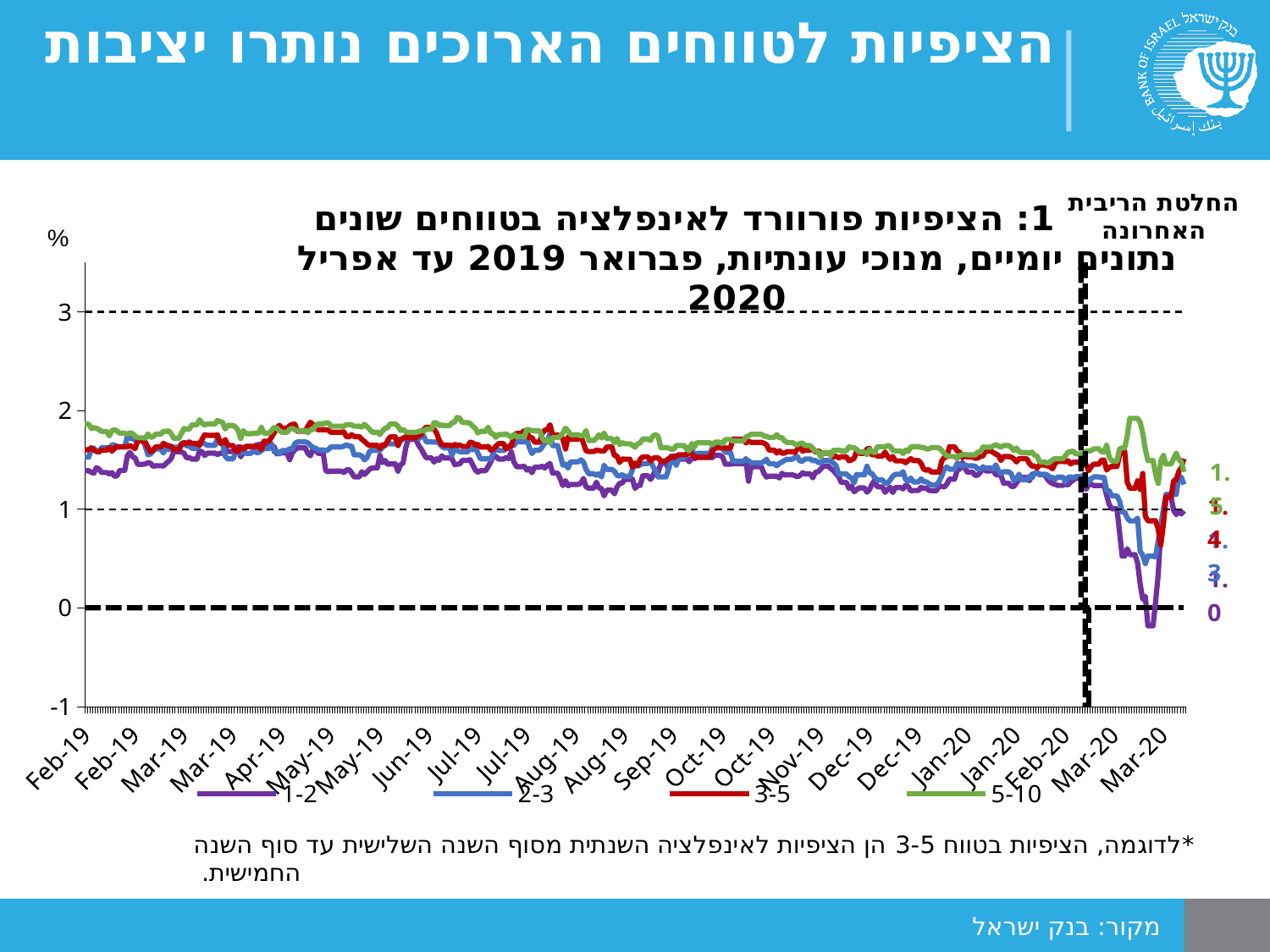
What are the four series listed in the legend? 1-2, 2-3, 3-5, 5-10 Is the value of the 3-5 series in Oct-19 greater or less than 2? less Is the value of the 2-3 series in Jul-19 greater or less than 1? greater Does the 1-2 series rise or fall sharply at the end of the period in Mar-20? fall What unit is shown on the vertical axis label? % Is the lowest value of the 1-2 series in Mar-20 greater or less than 0? less Which series drops to the lowest value in Mar-20? 1-2 Which series is the highest line for most of the period from Feb-19 to Feb-20? 5-10 In Feb-19, which series has the higher value, 5-10 or 1-2? 5-10 What kind of chart is shown on the slide? line chart How many series does the legend list? 4